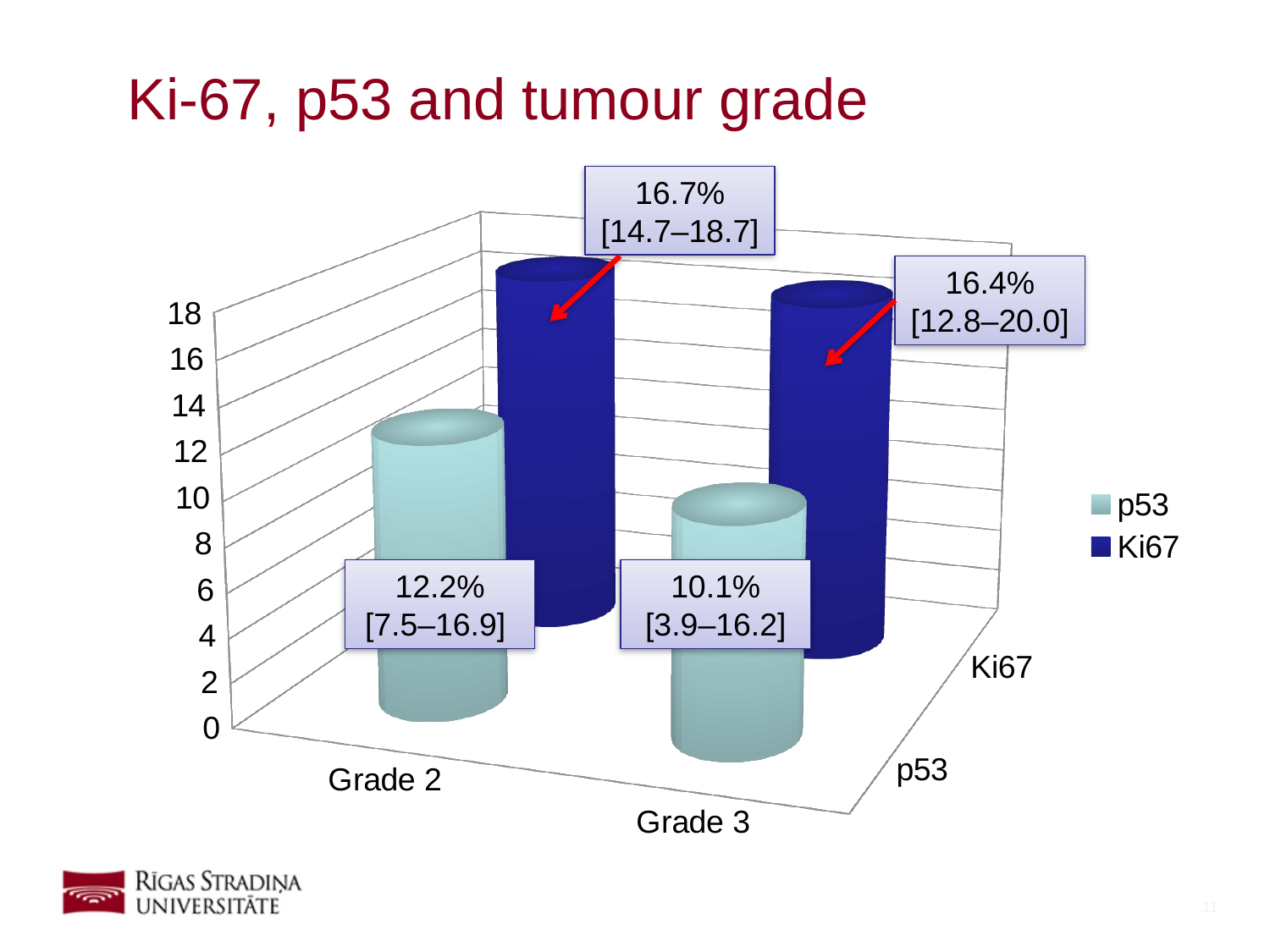
What kind of chart is shown on the slide? Bar chart What is the Ki67 value for Grade 2? 16.7% What is the difference between the p53 values for Grade 2 and Grade 3? 2.1 percentage points What is the p53 value for Grade 2? 12.2% What is the confidence interval shown for Ki67 in Grade 3? [12.8–20.0] Which series and grade has the highest value on the chart? Ki67, Grade 2 What is the title of the chart? Ki-67, p53 and tumour grade Which series and grade has the lowest value on the chart? p53, Grade 3 How many series does the legend list? 2 Which is larger, the Ki67 value for Grade 2 or for Grade 3? Grade 2 What is the Ki67 value for Grade 3? 16.4% What is the p53 value for Grade 3? 10.1%